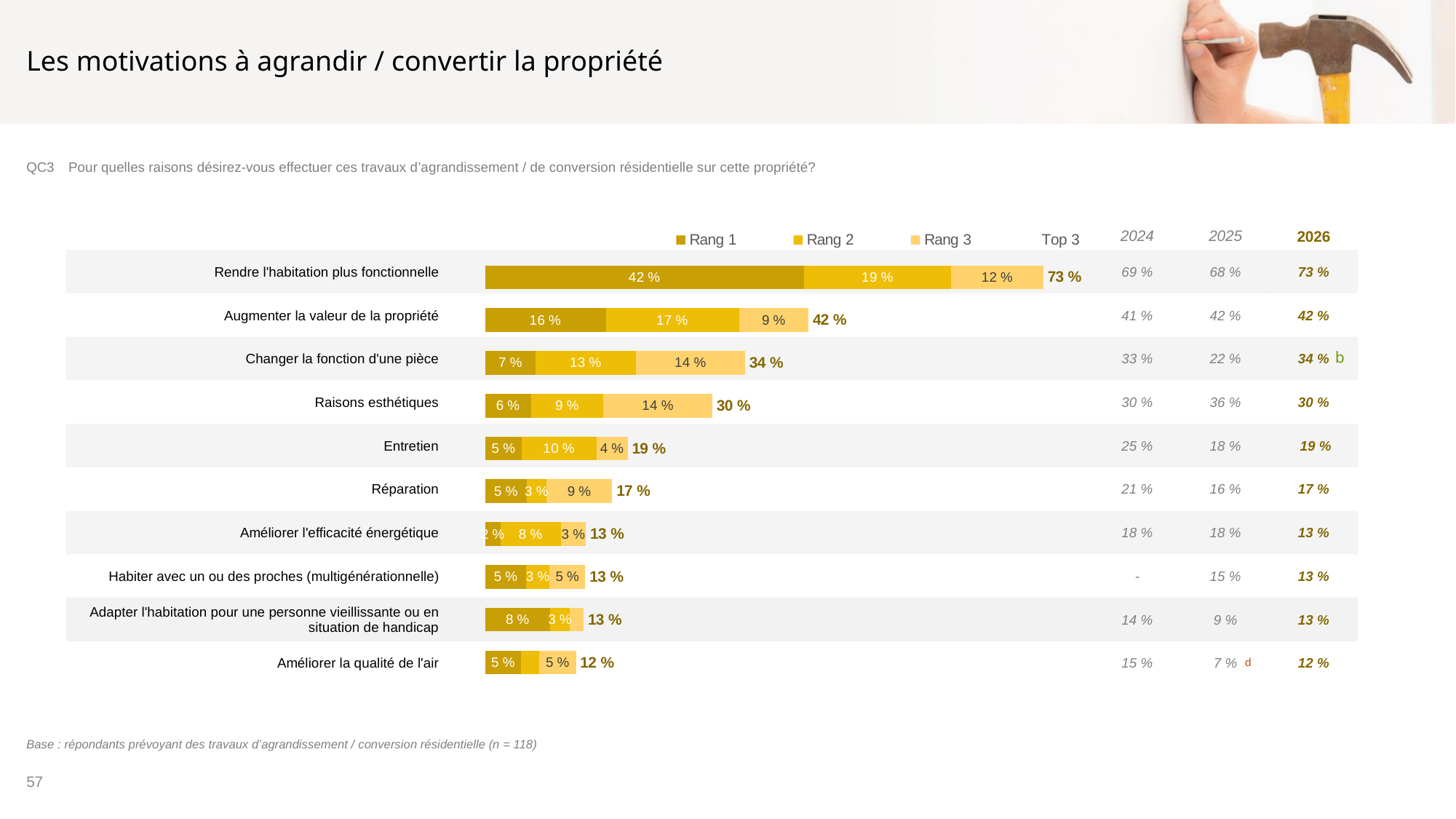
What is the Rang 1 value for "Rendre l'habitation plus fonctionnelle"? 42 % Which category has the highest Top 3 value? Rendre l'habitation plus fonctionnelle Which is larger: the Rang 2 value for "Augmenter la valeur de la propriété" or the Rang 2 value for "Changer la fonction d'une pièce"? Augmenter la valeur de la propriété What type of chart is shown on the slide? stacked bar chart What is the total of the stacked bar for "Entretien"? 19 % What is the difference between the Top 3 values for "Rendre l'habitation plus fonctionnelle" and "Augmenter la valeur de la propriété"? 31 % What is the Top 3 value for "Changer la fonction d'une pièce"? 34 % How many categories (motivations) are plotted in the chart? 10 How many coloured series (Rang) does the legend list? 3 What is the Rang 2 value for "Réparation"? 3 % What is the Rang 3 value for "Raisons esthétiques"? 14 % Which category has the lowest Top 3 value? Améliorer la qualité de l'air